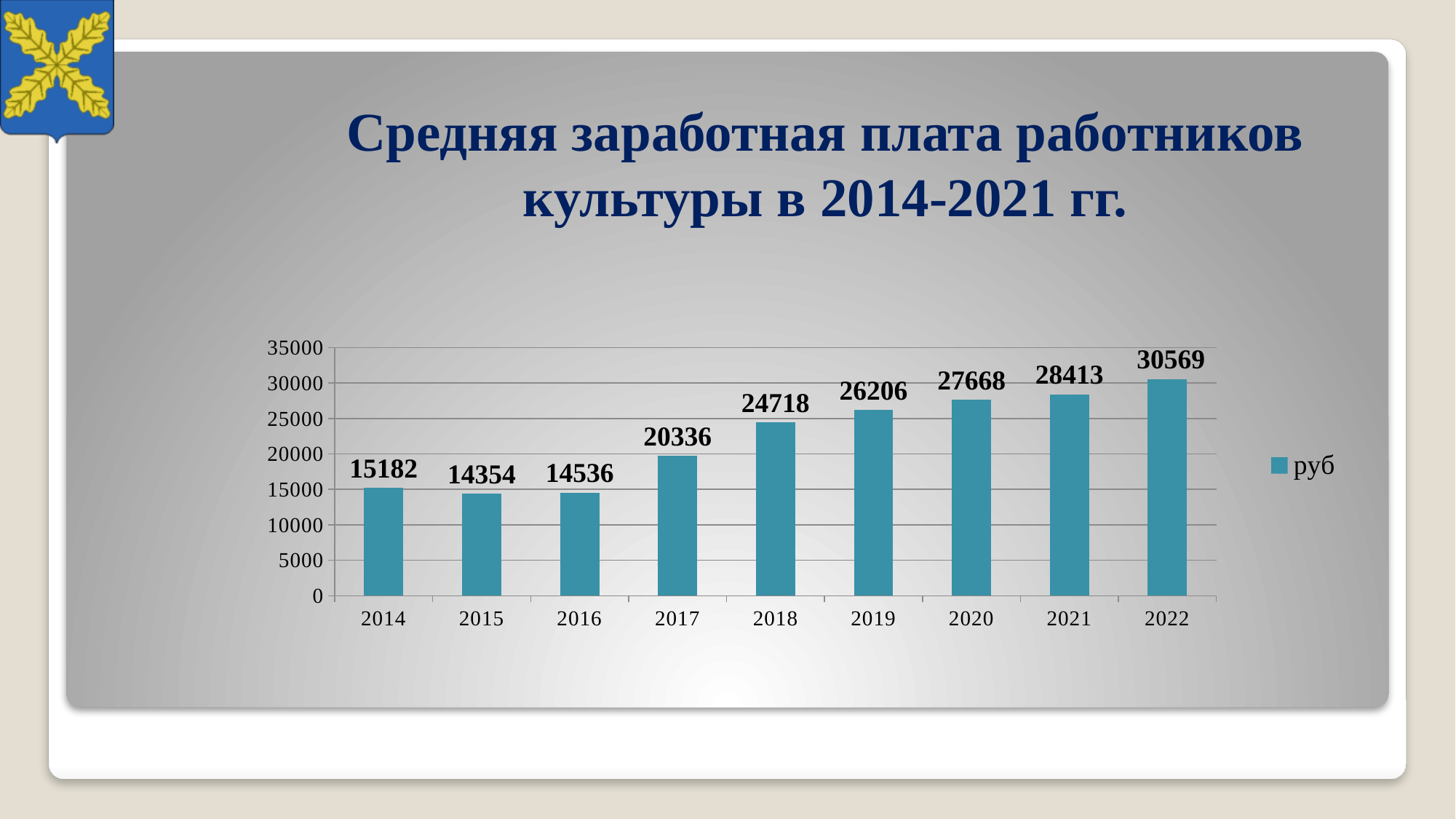
What is the value for 2014? 15182 What is the difference between the values for 2022 and 2014? 15387 Which year has the lowest value? 2015 What is the value for 2018? 24718 What is the value for 2022? 30569 What is the difference between the values for 2017 and 2016? 5800 What is the legend entry for the series? руб Which year has the highest value? 2022 How many years are shown on the x axis? 9 What kind of chart is shown on the slide? bar chart Which is larger, the value for 2019 or the value for 2020? 2020 Is the value for 2021 greater or less than 25000? greater